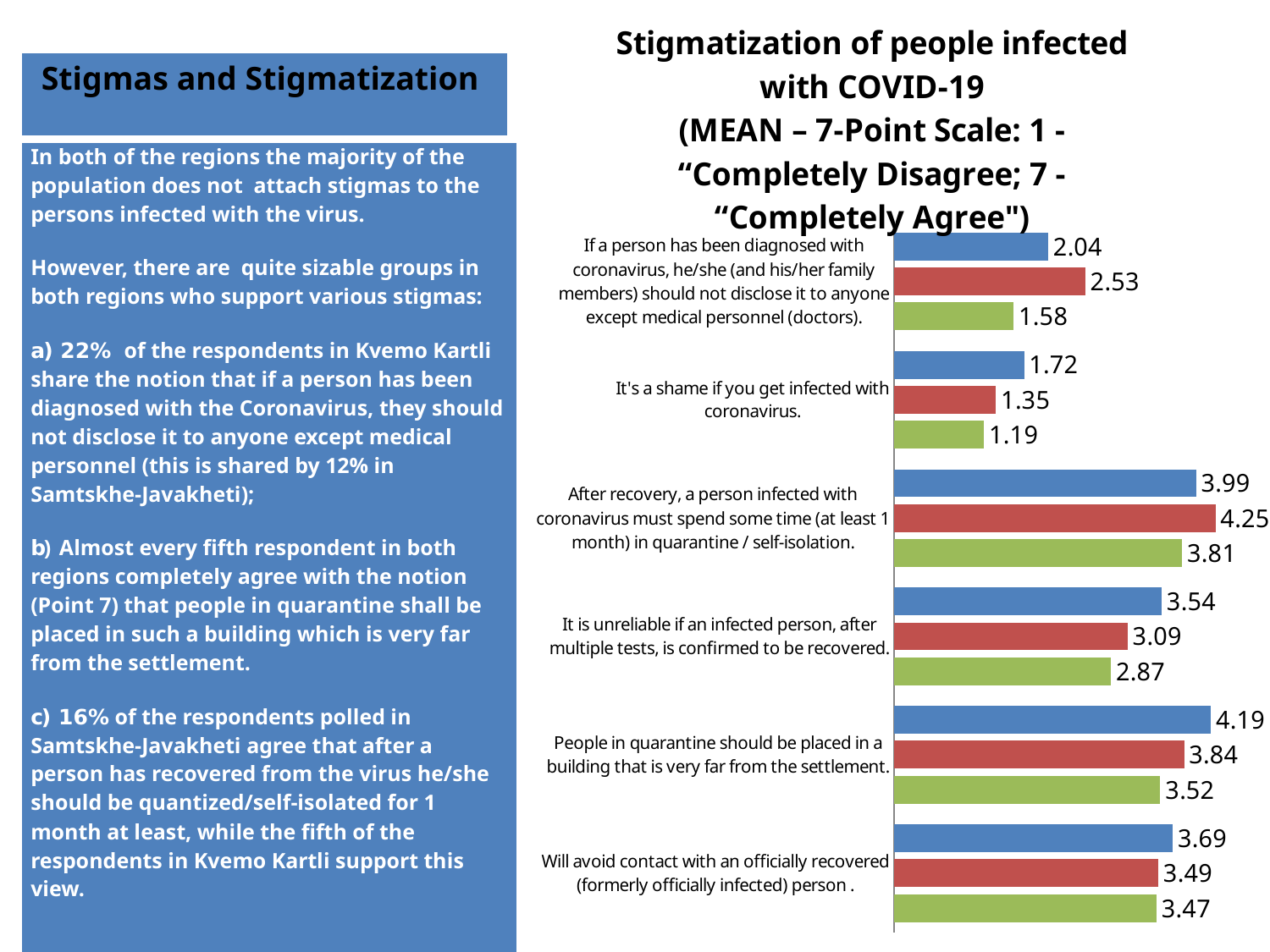
How many statements (categories) are shown in the chart? 6 For "Will avoid contact with an officially recovered (formerly officially infected) person .", which is larger: the blue bar or the green bar? The blue bar What is the value of the green bar for "People in quarantine should be placed in a building that is very far from the settlement."? 3.52 What is the difference between the red and green bar values for "If a person has been diagnosed with coronavirus, he/she (and his/her family members) should not disclose it to anyone except medical personnel (doctors)."? 0.95 What is the value of the blue bar for "It's a shame if you get infected with coronavirus."? 1.72 Which statement has the highest blue bar value? People in quarantine should be placed in a building that is very far from the settlement. Which statement has the lowest green bar value? It's a shame if you get infected with coronavirus. What is the value of the red bar for "After recovery, a person infected with coronavirus must spend some time (at least 1 month) in quarantine / self-isolation."? 4.25 What is the difference between the blue and red bar values for "People in quarantine should be placed in a building that is very far from the settlement."? 0.35 How many bars are shown for each statement in the chart? 3 For "It is unreliable if an infected person, after multiple tests, is confirmed to be recovered.", which is larger: the blue bar or the red bar? The blue bar What type of chart is shown on the slide? Bar chart